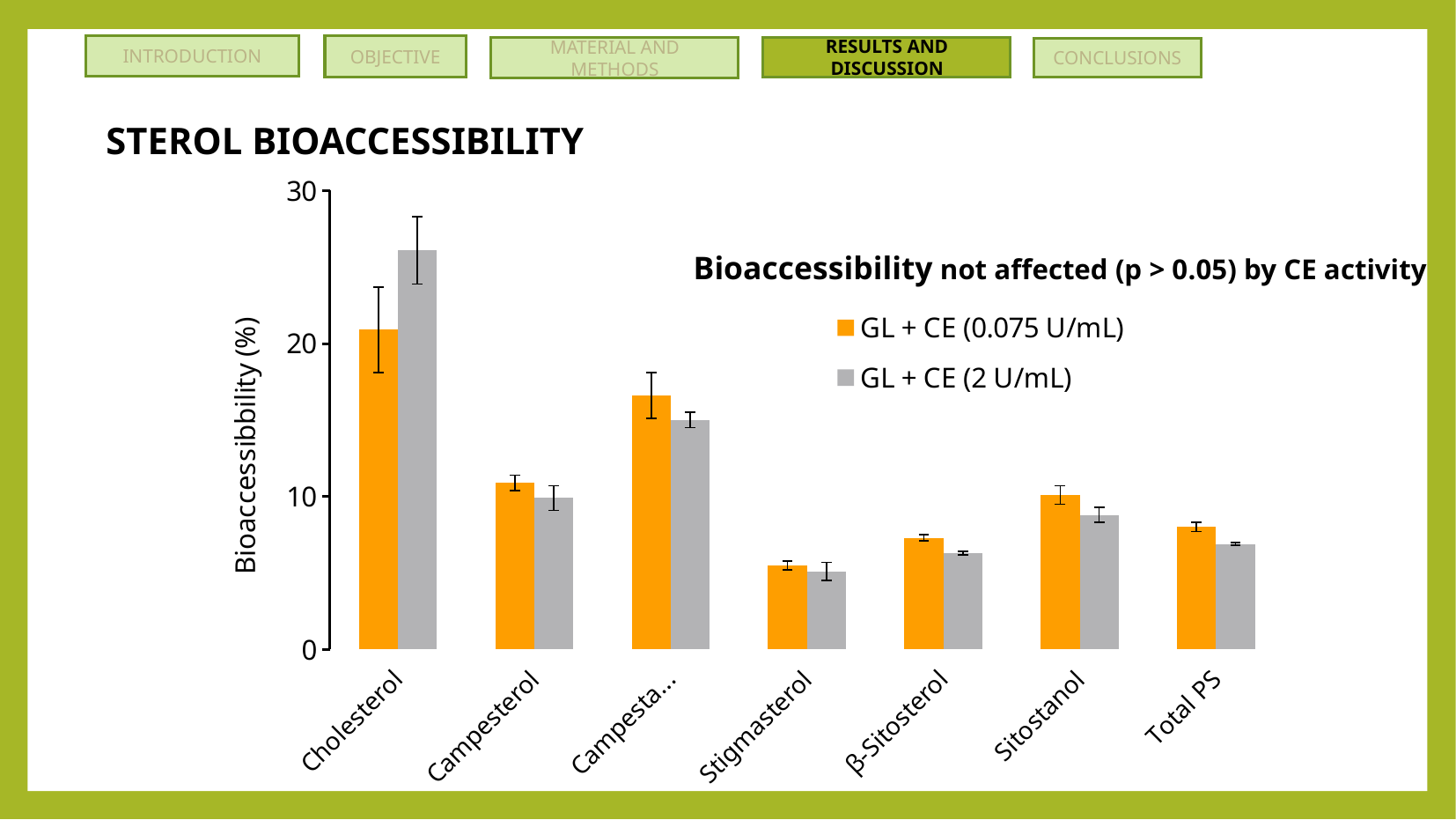
For Cholesterol, which series has the higher bioaccessibility: GL + CE (0.075 U/mL) or GL + CE (2 U/mL)? GL + CE (2 U/mL) Is the bioaccessibility of Total PS for GL + CE (2 U/mL) greater or less than 10? less Which category has the highest bioaccessibility for GL + CE (2 U/mL)? Cholesterol What kind of chart is shown on the slide? bar chart Which category has the lowest bioaccessibility for GL + CE (2 U/mL)? Stigmasterol Is the bioaccessibility of Cholesterol for GL + CE (2 U/mL) greater or less than 20? greater Is the bioaccessibility of Stigmasterol for GL + CE (0.075 U/mL) greater or less than 10? less Which category has the highest bioaccessibility for GL + CE (0.075 U/mL)? Cholesterol Which colour represents GL + CE (0.075 U/mL) in the chart? orange How many series does the chart legend list? 2 How many categories are shown on the x axis of the chart? 7 What is the label of the y axis? Bioaccessibbility (%)